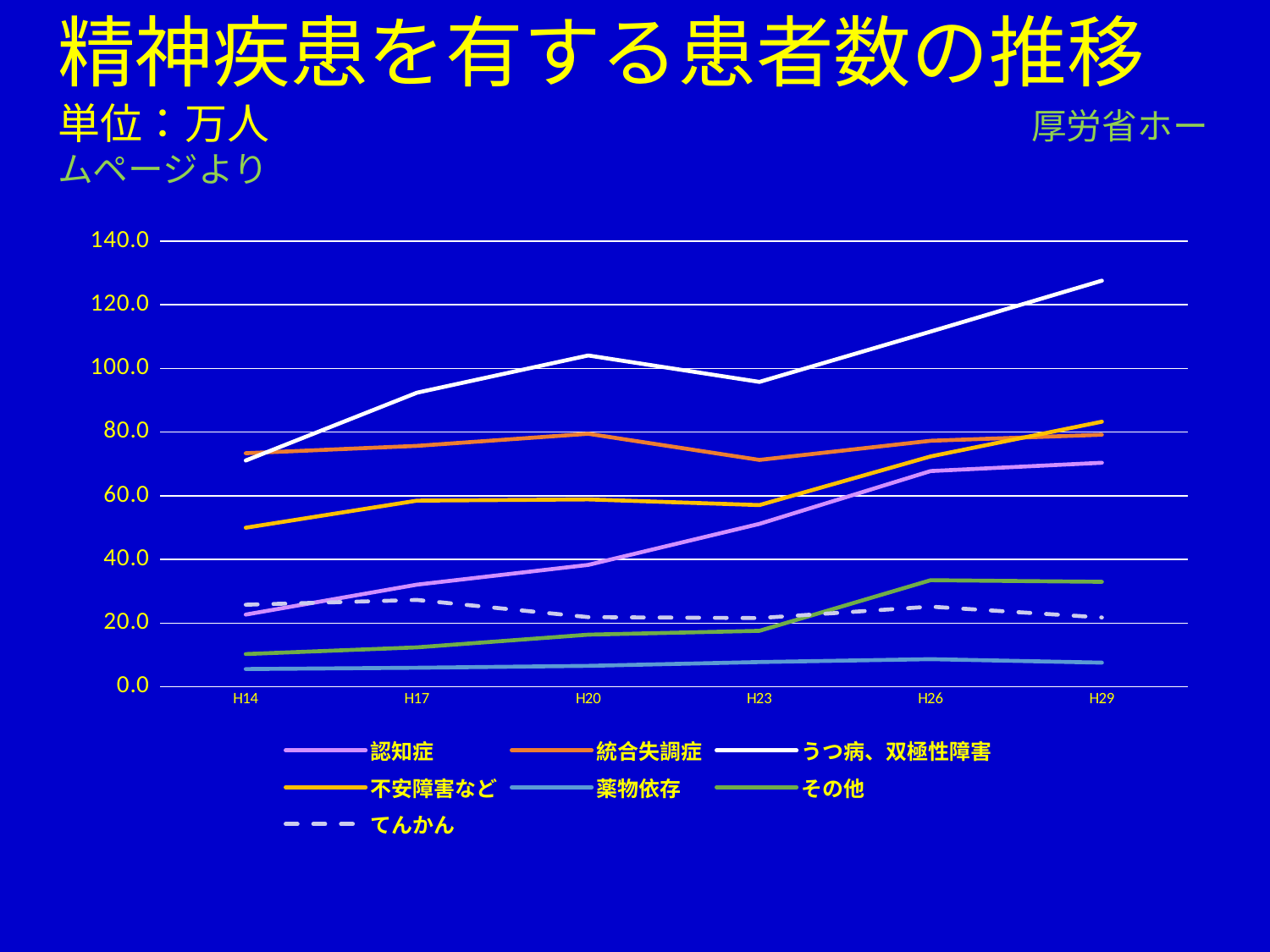
Which series is drawn with a dashed line? てんかん Is the value for うつ病、双極性障害 at H29 greater or less than 120? greater How many time points are shown on the x axis? 6 Is the value for 認知症 at H14 greater or less than 40? less Is the value for その他 at H26 greater or less than 20? greater At H20, which is larger: うつ病、双極性障害 or 認知症? うつ病、双極性障害 Which series has the highest value at H29? うつ病、双極性障害 How many series does the legend list? 7 What kind of chart is shown on the slide? line chart Does the value for 認知症 rise or fall from H14 to H29? rise Which series has the lowest value at H29? 薬物依存